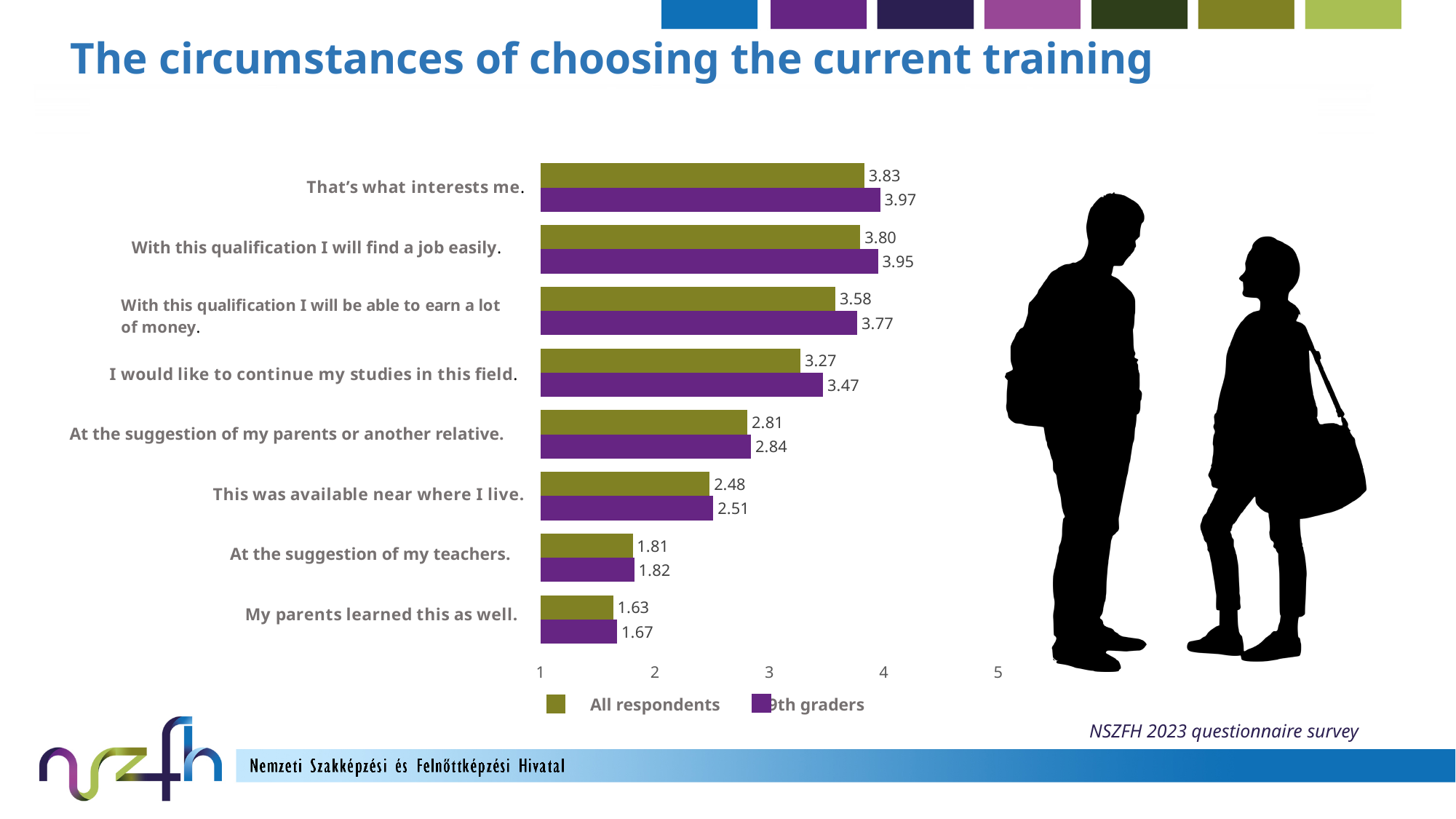
What is the difference between the '9th graders' and 'All respondents' values for 'With this qualification I will be able to earn a lot of money.'? 0.19 Which category has the lowest value for 'All respondents'? My parents learned this as well. How many series does the legend list? 2 What is the value for '9th graders' for 'At the suggestion of my teachers.'? 1.82 What is the value for '9th graders' for 'With this qualification I will find a job easily.'? 3.95 What kind of chart is shown on the slide? bar chart Which is larger for 'I would like to continue my studies in this field.': the 'All respondents' value or the '9th graders' value? 9th graders What is the value for 'All respondents' for 'That's what interests me.'? 3.83 Which category has the highest value for '9th graders'? That's what interests me. What colour are the bars for 'All respondents'? olive green Is the 'All respondents' value for 'This was available near where I live.' greater or less than 3? less How many categories are shown on the chart? 8